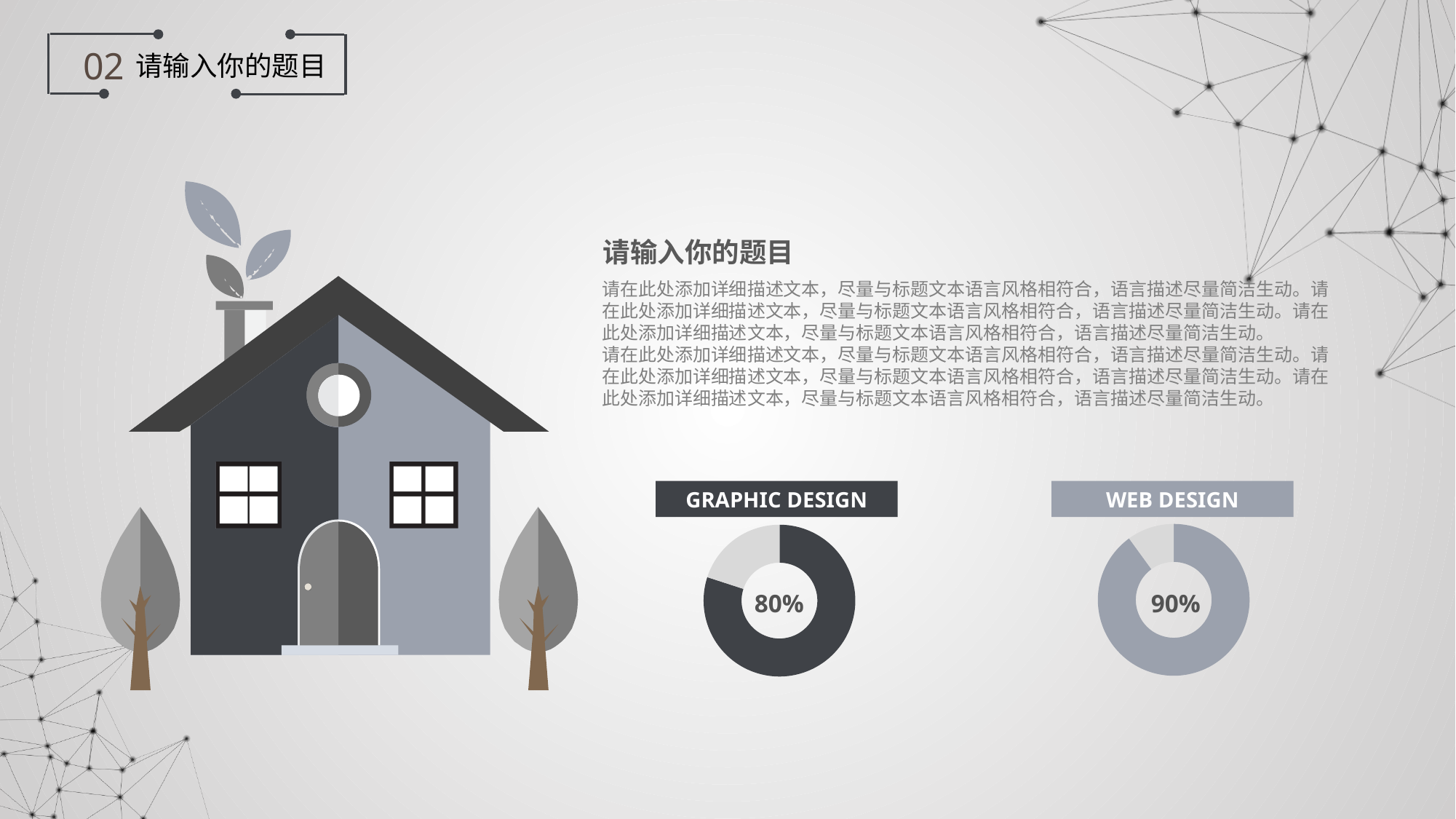
What is the difference between the WEB DESIGN percentage and the GRAPHIC DESIGN percentage? 10 percentage points In the WEB DESIGN donut chart, what share of the ring is filled by the blue-grey segment? 90% What is the heading above the left donut chart? GRAPHIC DESIGN Which of the two donut charts shows the lower percentage? GRAPHIC DESIGN What value is shown in the centre of the WEB DESIGN donut chart? 90% What kind of chart is used under the GRAPHIC DESIGN heading? Donut (pie) chart How many donut charts are shown on the slide? 2 In the GRAPHIC DESIGN donut chart, what share of the ring is filled by the dark segment? 80% Is the value shown in the GRAPHIC DESIGN donut chart greater or less than 50%? greater Which of the two donut charts shows the higher percentage, GRAPHIC DESIGN or WEB DESIGN? WEB DESIGN What value is shown in the centre of the GRAPHIC DESIGN donut chart? 80% What is the heading above the right donut chart? WEB DESIGN